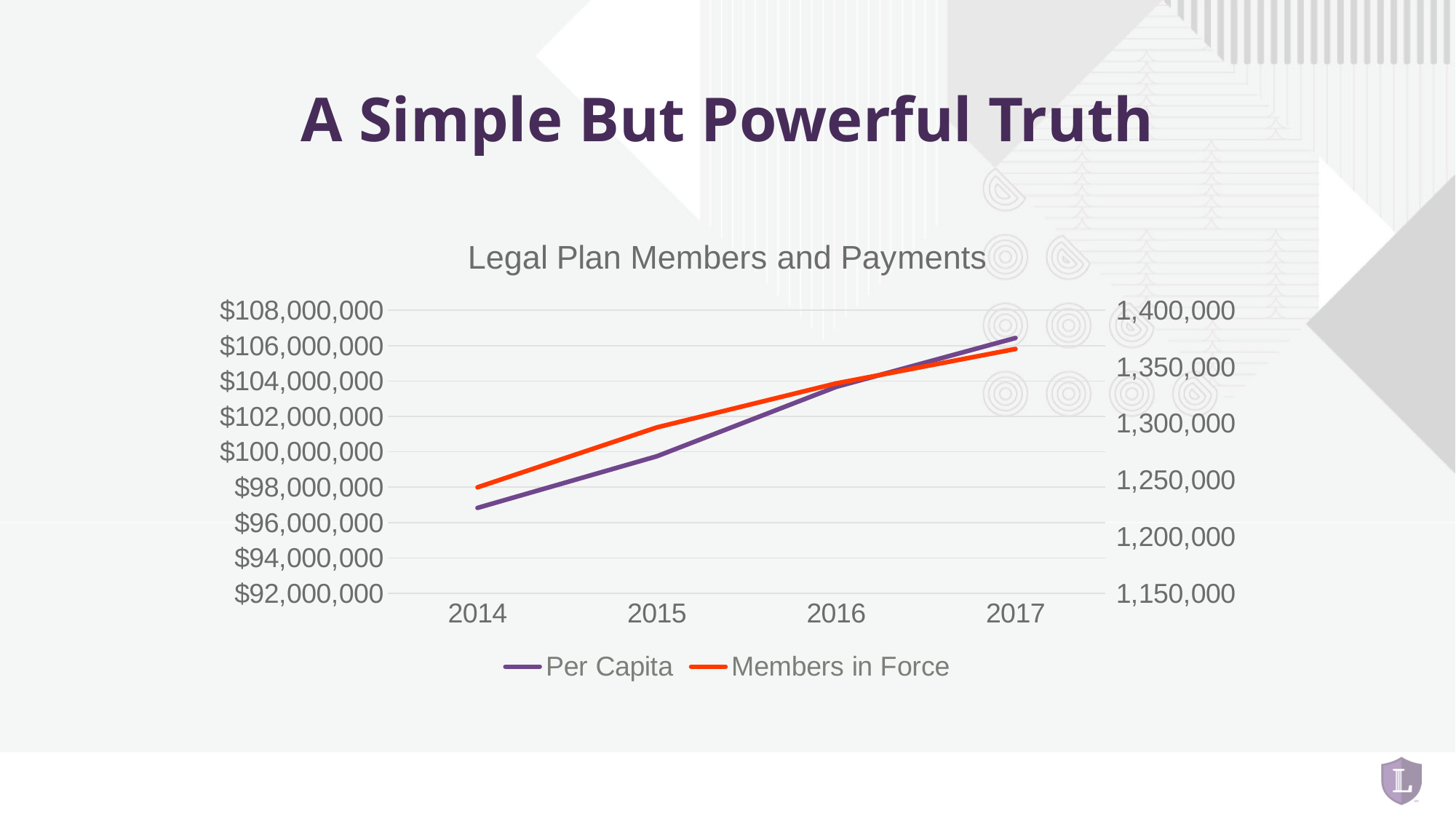
How many years are plotted along the x axis? 4 Is the Per Capita value for 2014 greater or less than $98,000,000? less Is the Members in Force value for 2017 greater or less than 1,350,000? greater Which series is drawn in orange? Members in Force Is the Per Capita value for 2016 greater or less than $102,000,000? greater Does the Per Capita line rise or fall from 2014 to 2017? Rises Does the Members in Force line rise or fall from 2014 to 2017? Rises How many series does the legend list? 2 What is the title of the chart? Legal Plan Members and Payments In which year is Members in Force lowest? 2014 In which year is Per Capita highest? 2017 What kind of chart is shown on the slide? Line chart